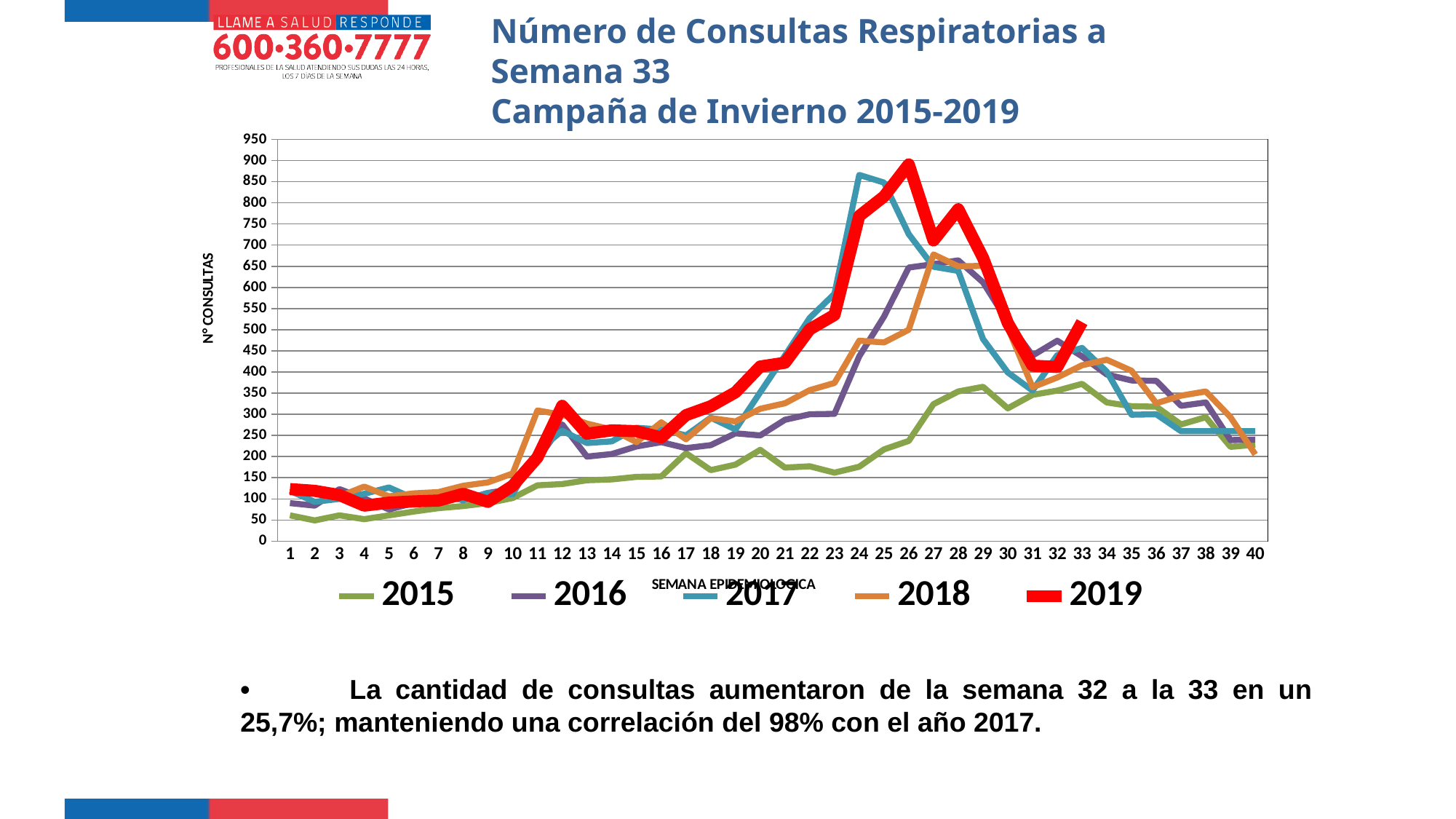
Is the value for 2017 at week 24 greater or less than 800? greater What kind of chart is shown on the slide? line chart What is the title of the y axis? N° CONSULTAS Which series has the lowest value at week 20? 2015 At week 24, which is larger: the value for 2017 or the value for 2019? 2017 Is the value for 2019 at week 26 greater or less than 850? greater Is the value for 2015 at week 26 greater or less than 300? less Does the 2019 series rise or fall from week 26 to week 31? fall How many series does the legend list? 5 Which series reaches the highest peak on the chart? 2019 How many epidemiological weeks are shown on the x axis? 40